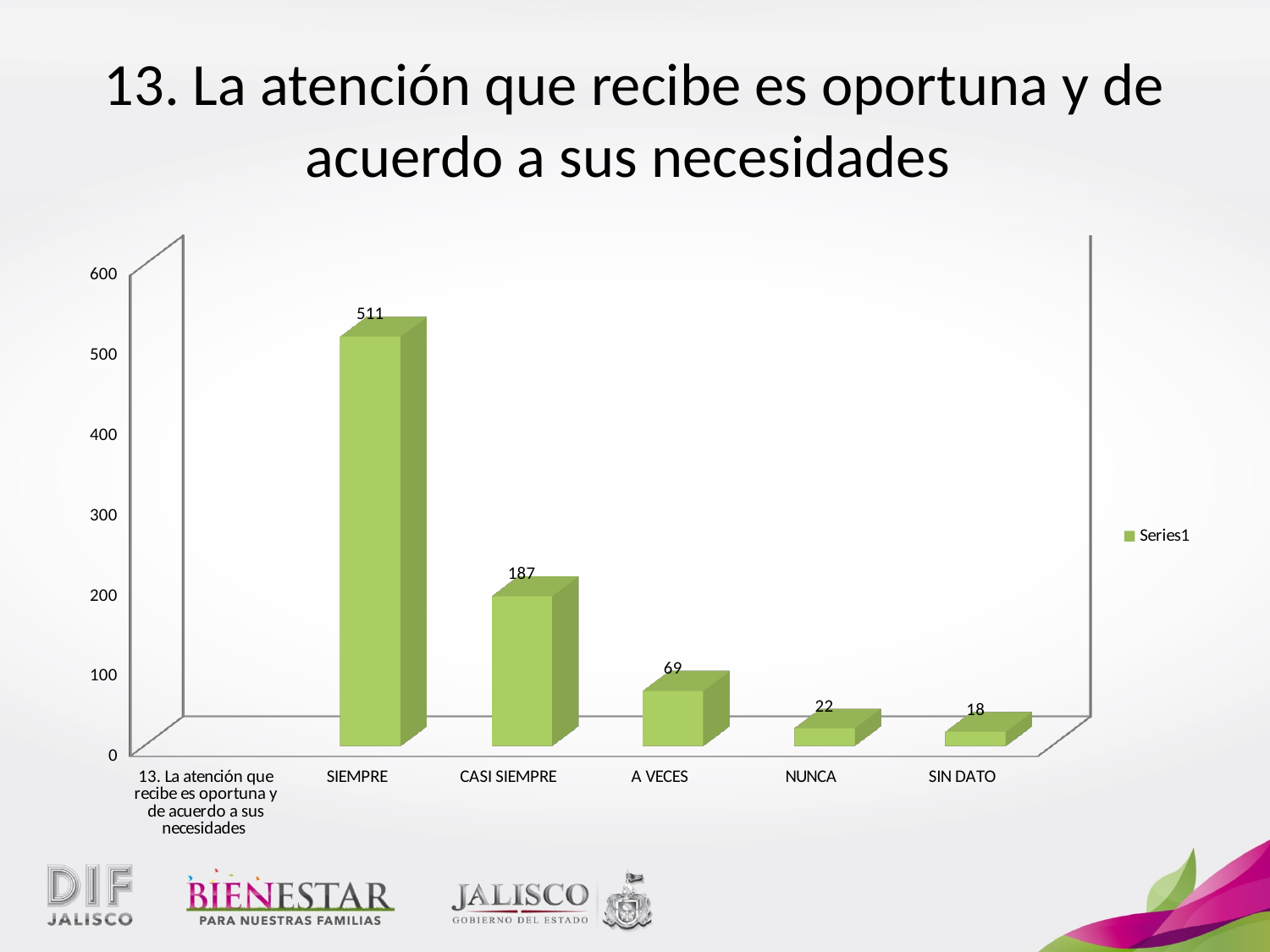
What is the value for SIN DATO? 18 Which is larger, the value for A VECES or the value for NUNCA? A VECES Which category has the highest value? SIEMPRE Which category has the lowest value? SIN DATO How many bars are plotted in the chart? 5 What is the value for SIEMPRE? 511 What is the value for CASI SIEMPRE? 187 What is the difference between the values for SIEMPRE and CASI SIEMPRE? 324 What kind of chart is shown on the slide? Bar chart What is the name of the series listed in the legend? Series1 What is the value for NUNCA? 22 What is the value for A VECES? 69